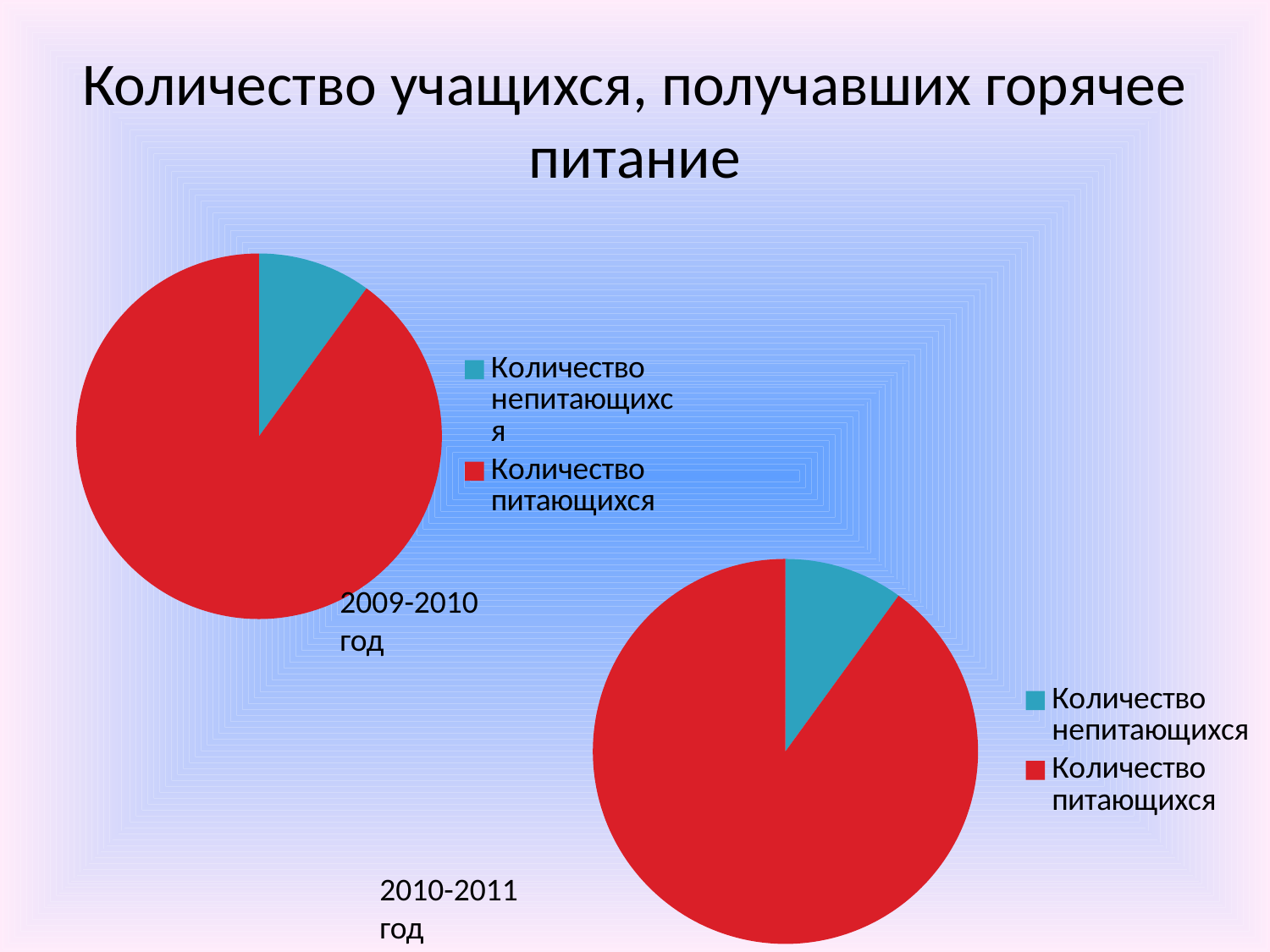
How many charts are shown on the slide? 2 In the 2010-2011 год pie chart, which category has the largest slice? Количество питающихся How many entries does the legend of the 2009-2010 год chart list? 2 In the 2009-2010 год pie chart, which category has the largest slice? Количество питающихся What kind of chart is the 2010-2011 год chart? pie chart In the 2009-2010 год pie chart, which category has the smallest slice? Количество непитающихся What is the title of the slide? Количество учащихся, получавших горячее питание How many slices does the 2009-2010 год pie chart have? 2 What kind of chart is the 2009-2010 год chart? pie chart In the 2010-2011 год pie chart, which is larger: Количество непитающихся or Количество питающихся? Количество питающихся In the 2010-2011 год pie chart, what colour is the Количество питающихся slice? red How many slices does the 2010-2011 год pie chart have? 2